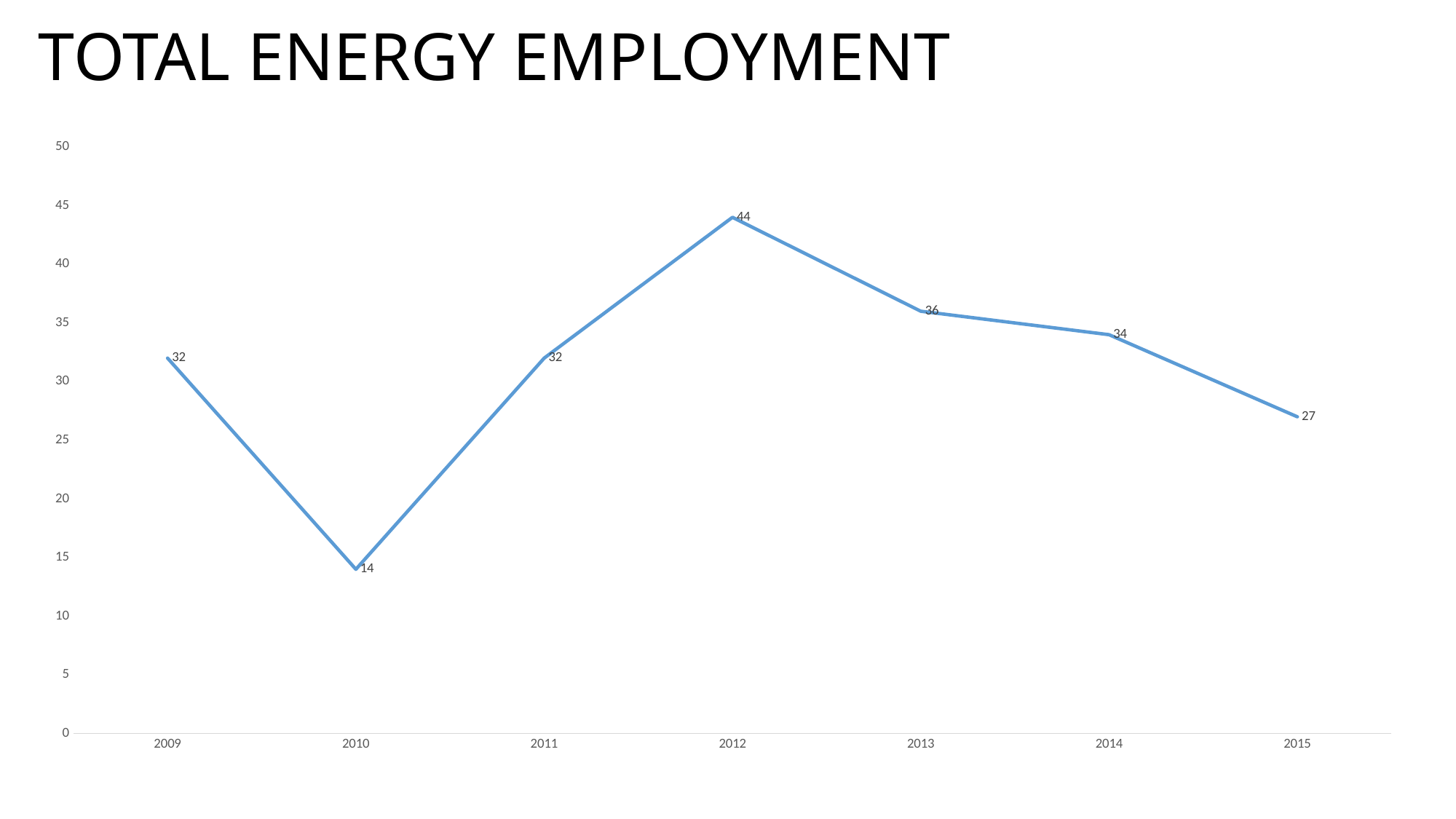
Which year has the highest value? 2012 What kind of chart is shown? line chart What is the value for 2010? 14 What is the difference between the values for 2013 and 2015? 9 Is the value for 2011 greater or less than 30? greater What is the title of the chart? TOTAL ENERGY EMPLOYMENT How many years are plotted on the x axis? 7 What is the value for 2012? 44 Which year has the lowest value? 2010 What is the value for 2015? 27 What is the difference between the values for 2012 and 2010? 30 Which is larger, the value for 2013 or the value for 2014? 2013